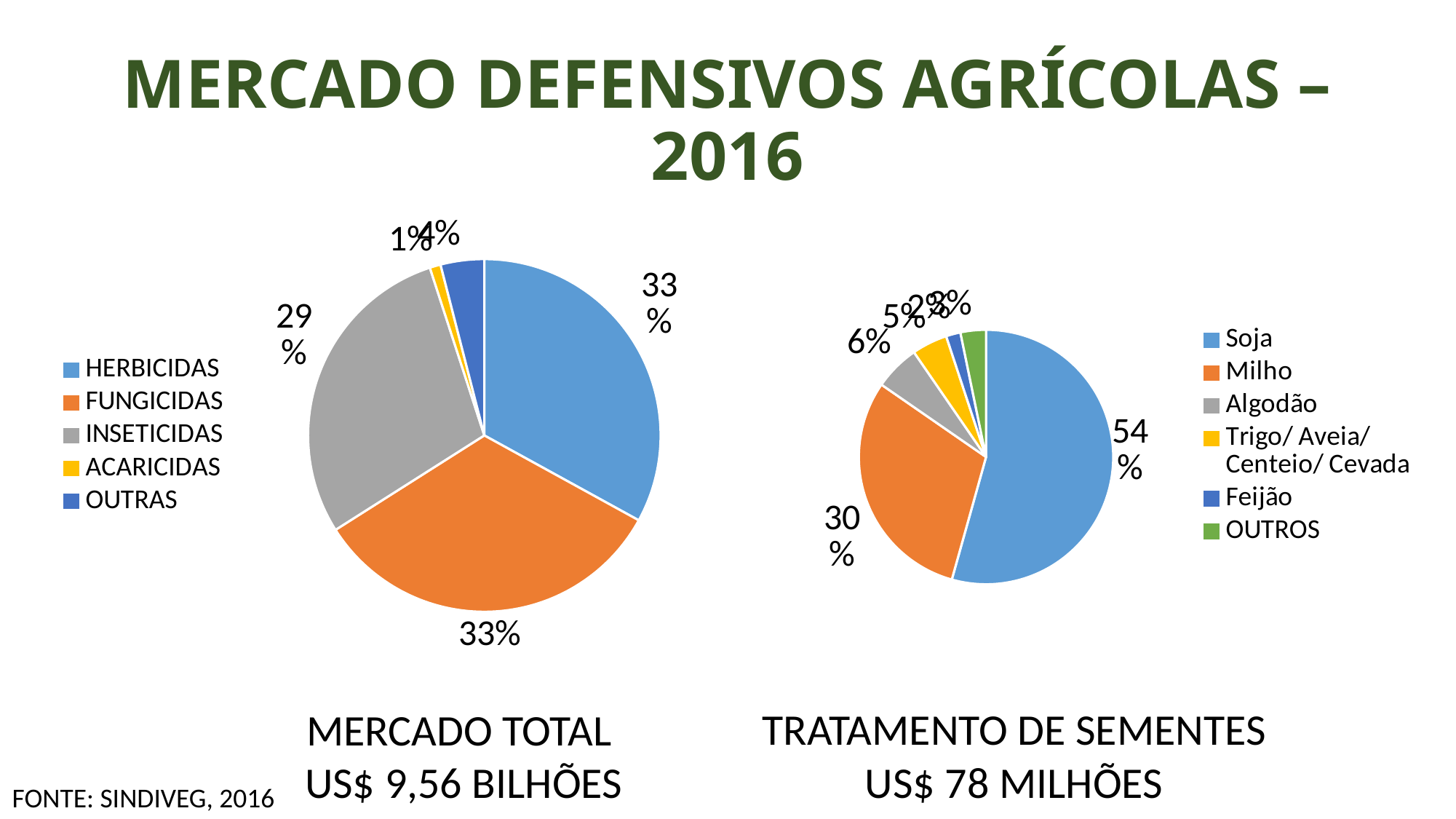
On the MERCADO TOTAL chart, what share does HERBICIDAS have? 33% On the MERCADO TOTAL chart, which category has the smallest slice? ACARICIDAS On the TRATAMENTO DE SEMENTES chart, what share does Algodão have? 6% On the MERCADO TOTAL chart, how many categories does the legend list? 5 On the TRATAMENTO DE SEMENTES chart, what is the difference in percentage points between Soja and Milho? 24 percentage points On the MERCADO TOTAL chart, what share does FUNGICIDAS have? 33% On the TRATAMENTO DE SEMENTES chart, what share does Soja have? 54% On the TRATAMENTO DE SEMENTES chart, what share does Milho have? 30% On the TRATAMENTO DE SEMENTES chart, which category has the largest slice? Soja On the MERCADO TOTAL chart, what is the difference in percentage points between HERBICIDAS and INSETICIDAS? 4 percentage points What kind of chart is the TRATAMENTO DE SEMENTES chart? Pie chart On the MERCADO TOTAL chart, what share does INSETICIDAS have? 29%